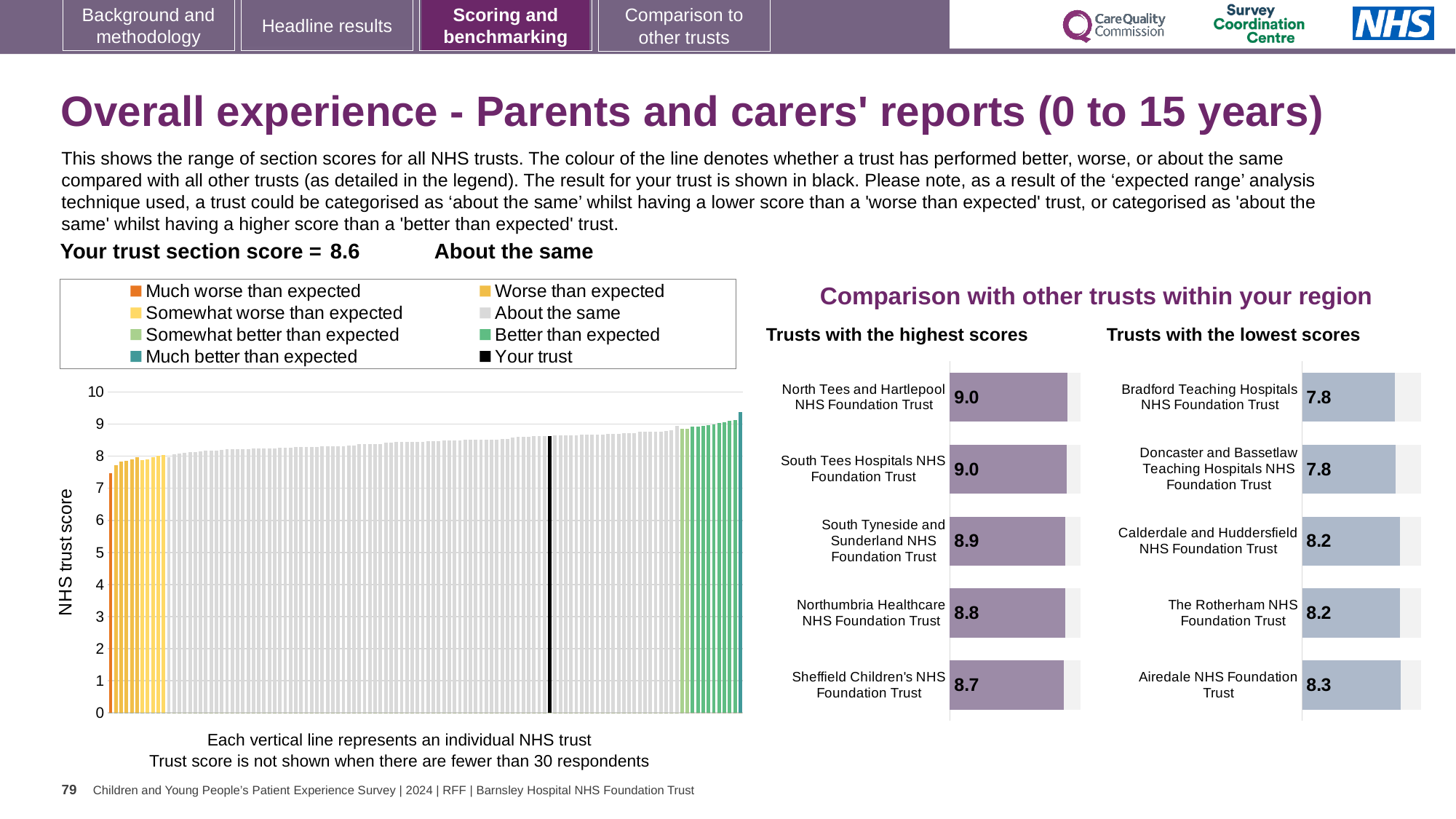
In the 'Trusts with the highest scores' chart, what is the score for North Tees and Hartlepool NHS Foundation Trust? 9.0 How many entries does the legend of the large chart on the left list? 8 How many trusts are shown in the 'Trusts with the lowest scores' chart? 5 In the 'Trusts with the highest scores' chart, which trust has the lowest score? Sheffield Children's NHS Foundation Trust In the large chart on the left, is the value for the black 'Your trust' bar greater or less than 8? greater Which has the higher score: Northumbria Healthcare NHS Foundation Trust in the highest scores chart or Calderdale and Huddersfield NHS Foundation Trust in the lowest scores chart? Northumbria Healthcare NHS Foundation Trust In the 'Trusts with the lowest scores' chart, which trust has the highest score? Airedale NHS Foundation Trust In the 'Trusts with the lowest scores' chart, what is the score for Bradford Teaching Hospitals NHS Foundation Trust? 7.8 What is the difference between the score for North Tees and Hartlepool NHS Foundation Trust in the highest scores chart and the score for Bradford Teaching Hospitals NHS Foundation Trust in the lowest scores chart? 1.2 In the 'Trusts with the lowest scores' chart, what is the score for Airedale NHS Foundation Trust? 8.3 In the 'Trusts with the highest scores' chart, what is the score for Sheffield Children's NHS Foundation Trust? 8.7 What type of chart is the large chart on the left with the y-axis labelled 'NHS trust score'? bar chart